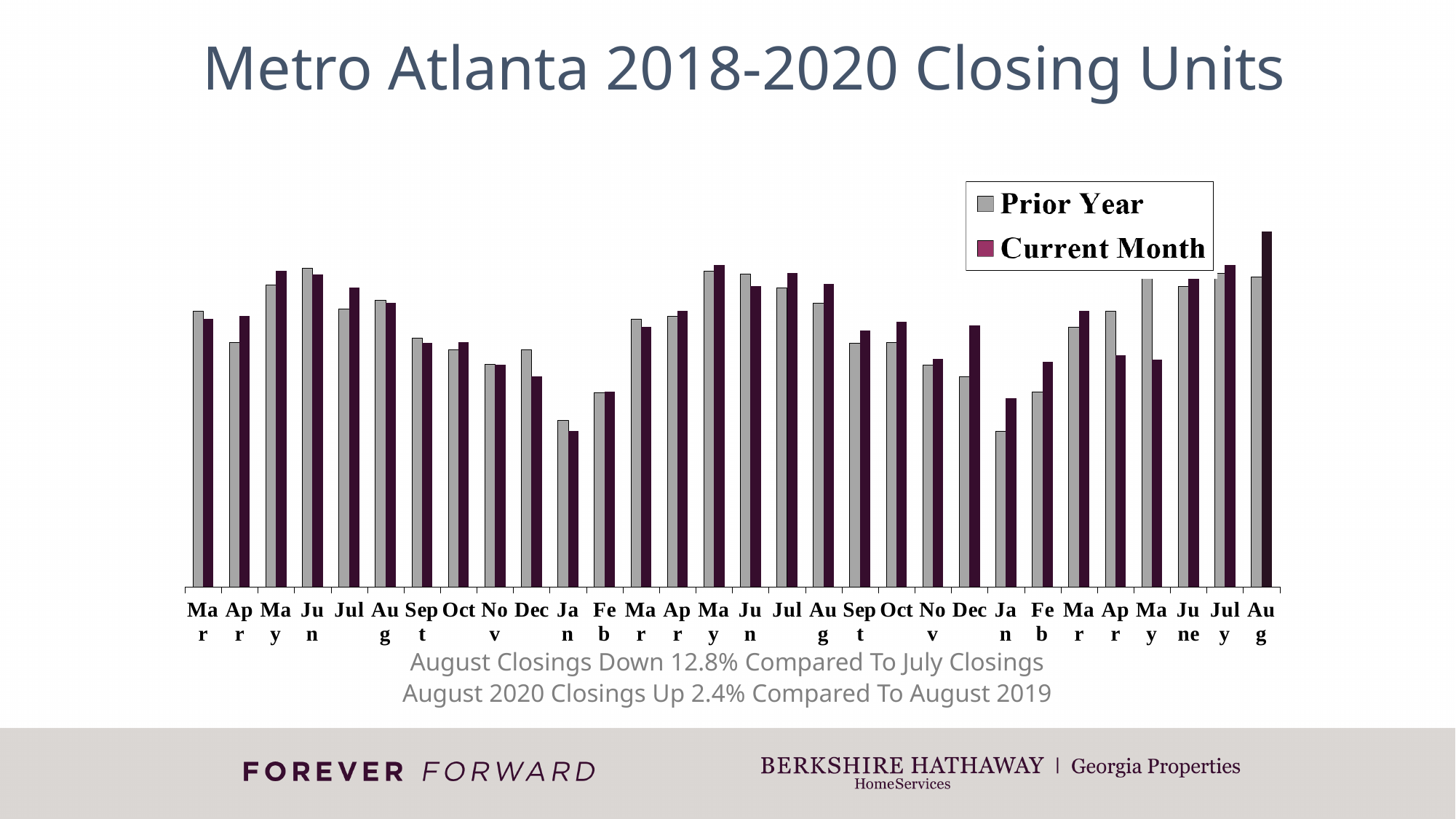
For the rightmost Aug, which is larger: the Prior Year bar or the Current Month bar? Current Month What kind of chart is shown on the slide? bar chart Do the Current Month bars rise or fall from the second Jan shown to the rightmost Aug? rise Which month has the shortest Current Month bar? Jan (the first Jan shown) How many months are shown along the x axis? 30 What are the two series named in the legend? Prior Year and Current Month For the rightmost May, which is larger: the Prior Year bar or the Current Month bar? Prior Year For the first Jan shown, which is larger: the Prior Year bar or the Current Month bar? Prior Year How many series does the legend list? 2 Which month has the shortest Prior Year bar? Jan (the second Jan shown) What is the title of the chart? Metro Atlanta 2018-2020 Closing Units Which month has the tallest Current Month bar? Aug (the rightmost month)